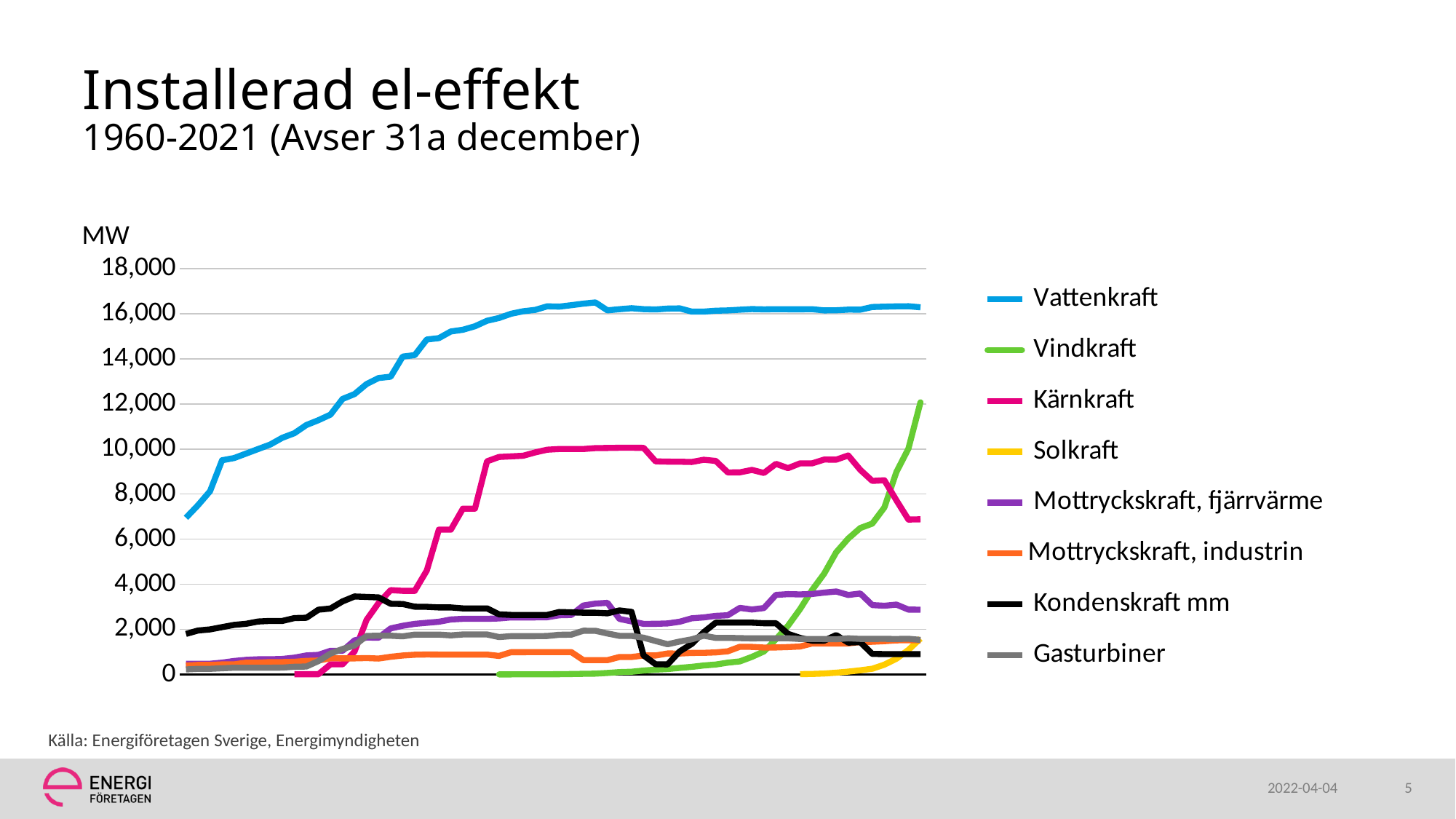
Which series is drawn in yellow? Solkraft How many series does the legend list? 8 Which series has the lowest value at the right end of the chart? Kondenskraft mm Does the Vindkraft line rise or fall toward the right end of the chart? rises What unit is shown on the y axis? MW Which series has the highest values across the whole period? Vattenkraft Is the final value for Kärnkraft greater or less than 8,000? less Is the final value for Solkraft greater or less than 2,000? less What kind of chart is shown on the slide? line chart At the right end of the chart, which is larger: Vindkraft or Kärnkraft? Vindkraft Is the peak value for Vattenkraft greater or less than 16,000? greater